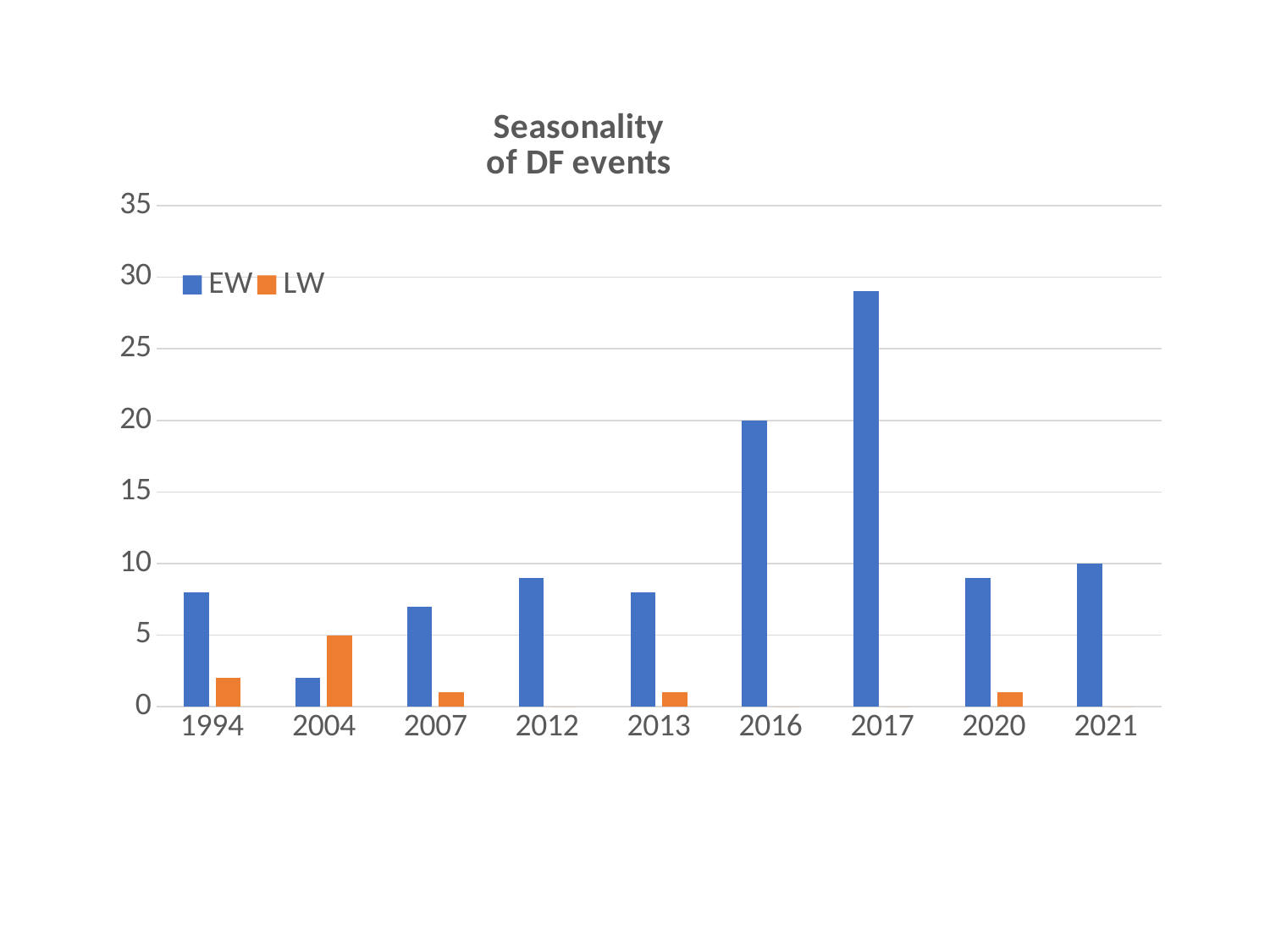
What is the title of the chart? Seasonality of DF events How many series does the legend list? 2 What type of chart is shown on the slide? bar chart Is the EW value for 2004 greater or less than 5? less Which is larger in 2004, the EW value or the LW value? LW Which year has the highest LW value? 2004 What is the EW value for 2021? 10 Which year has the highest EW value? 2017 What is the EW value for 2016? 20 How many years are shown on the x axis? 9 What is the LW value for 2004? 5 Is the EW value for 2017 greater or less than 25? greater